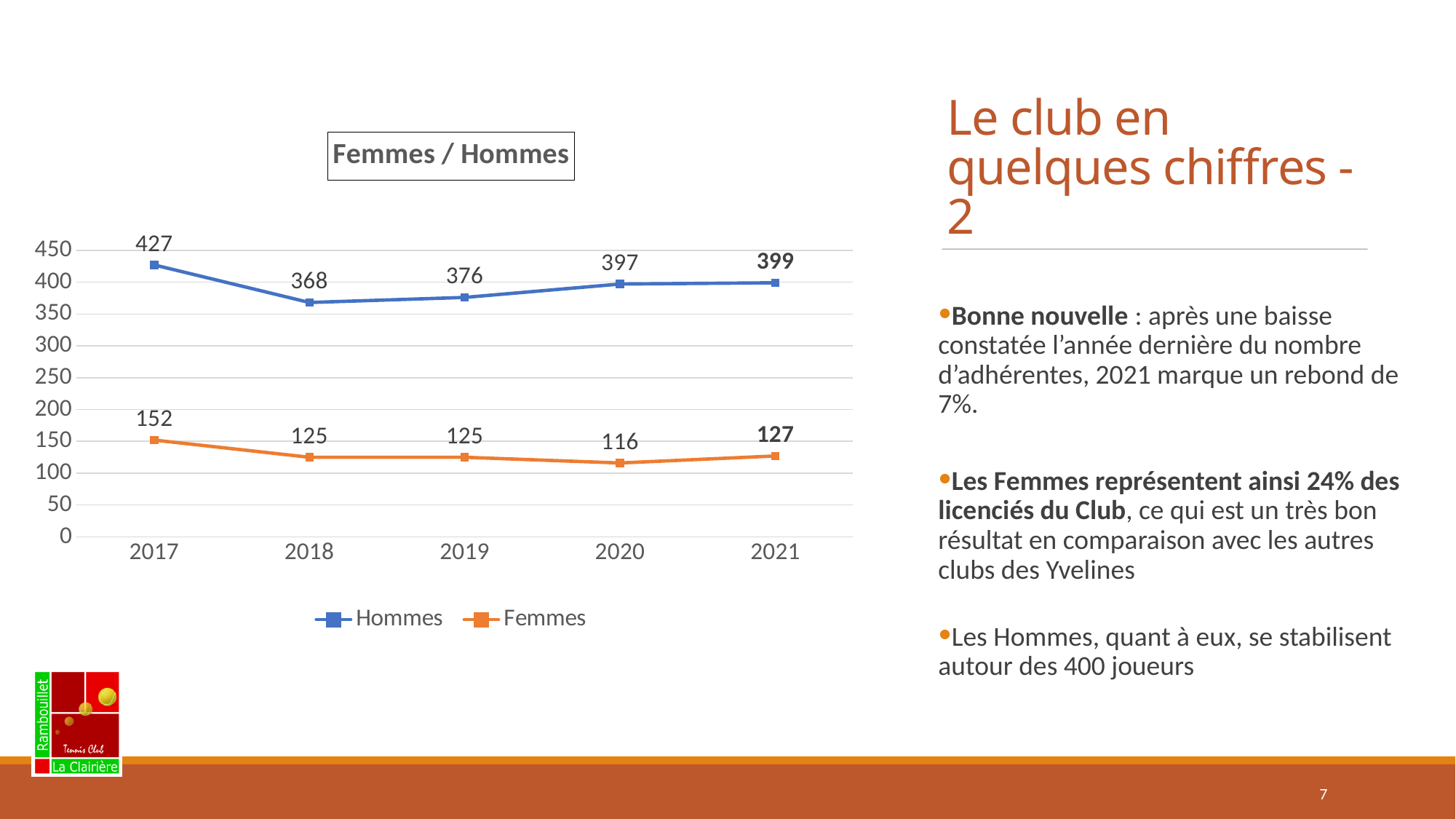
What is the difference between the Hommes values in 2017 and 2018? 59 In which year is the Femmes series highest? 2017 What is the title of the chart? Femmes / Hommes What is the value for Femmes in 2020? 116 Is the Hommes value in 2021 greater or less than 350? greater What kind of chart is shown? line chart How many series does the legend list? 2 In which year is the Hommes series lowest? 2018 What is the value for Hommes in 2017? 427 What is the value for Femmes in 2021? 127 How many years are shown on the x axis? 5 Which is larger: the Femmes value in 2019 or in 2020? 2019